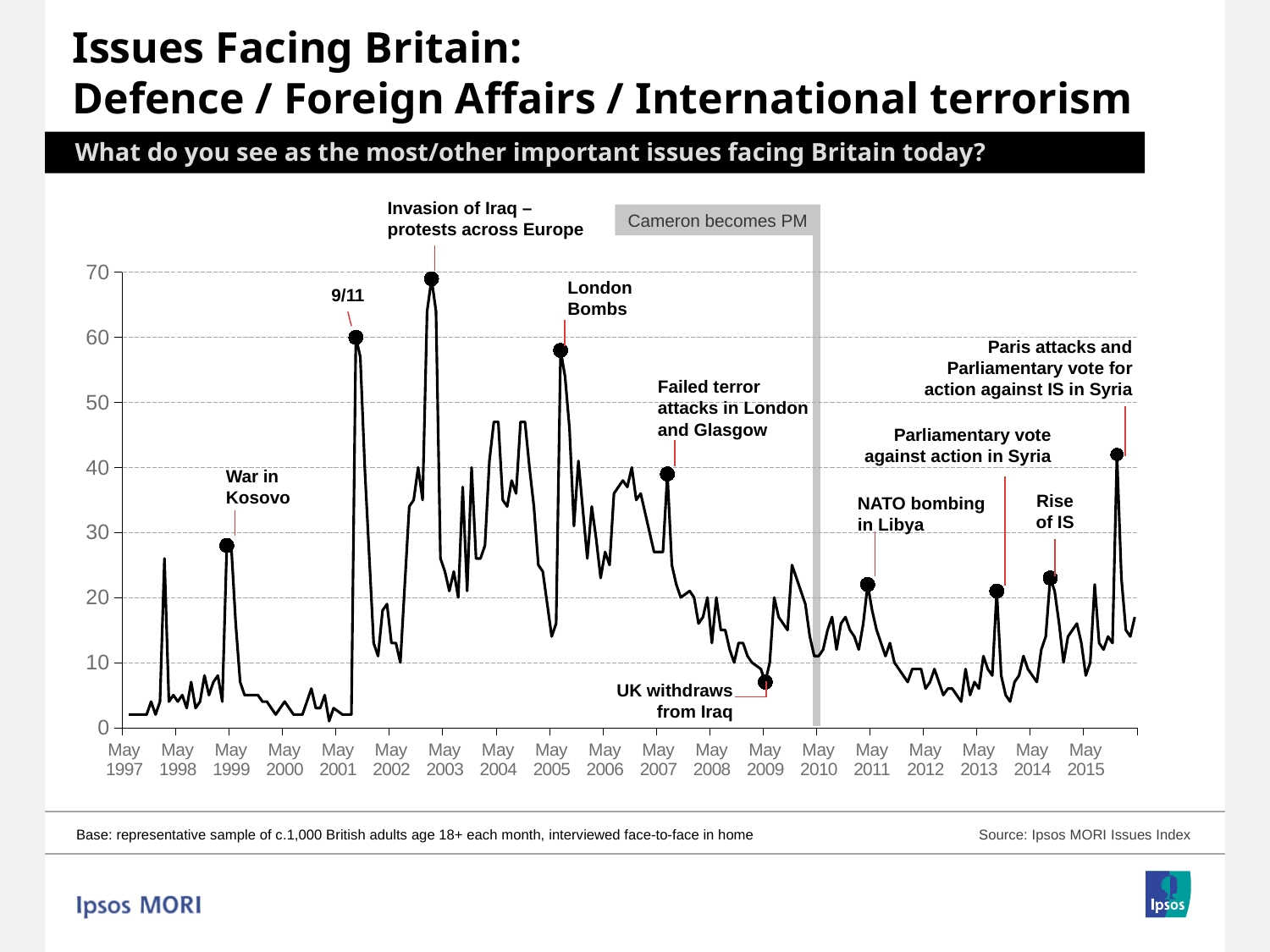
What kind of chart is shown on the slide? line chart Which annotated event marks the lowest point on the line? UK withdraws from Iraq Is the value at the 'NATO bombing in Libya' point greater or less than 30? less Is the value at the 'Invasion of Iraq – protests across Europe' peak greater or less than 60? greater What event does the grey vertical bar on the chart mark? Cameron becomes PM Is the value at the 'Failed terror attacks in London and Glasgow' point greater or less than 30? greater Which annotated event marks the highest point on the line? Invasion of Iraq – protests across Europe Which is higher, the 'War in Kosovo' point or the 'NATO bombing in Libya' point? War in Kosovo